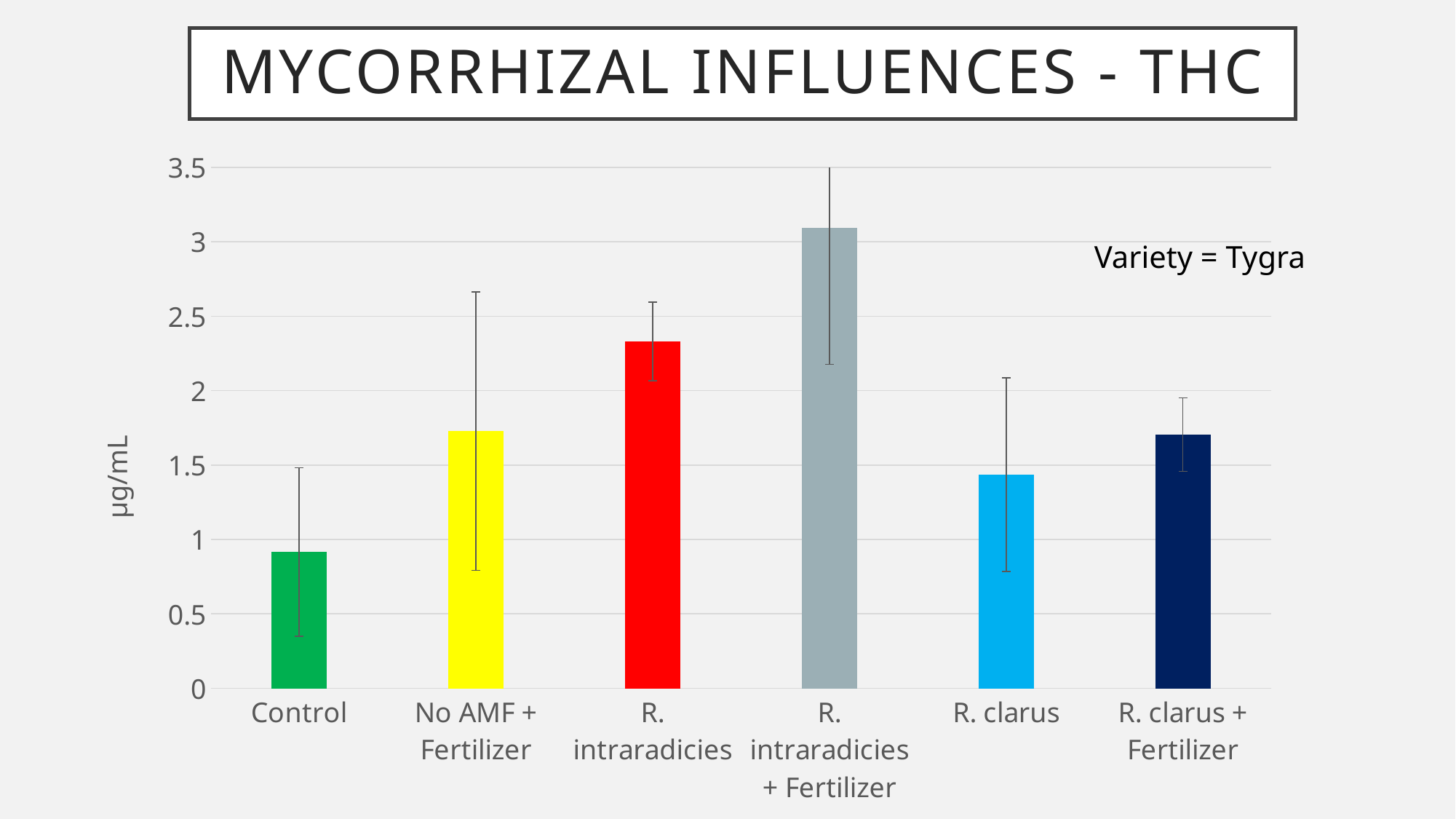
Which category has the highest THC value? R. intraradicies + Fertilizer Is the value for No AMF + Fertilizer greater or less than 1.5? greater Is the value for R. clarus greater or less than 1.5? less Which category has the lowest THC value? Control What is the title of the chart? MYCORRHIZAL INFLUENCES - THC Which is larger, the value for R. intraradicies or the value for R. clarus? R. intraradicies How many categories are plotted on the x axis? 6 Is the value for R. intraradicies + Fertilizer greater or less than 3? greater What is the unit shown on the y axis? µg/mL What type of chart is shown on the slide? bar chart